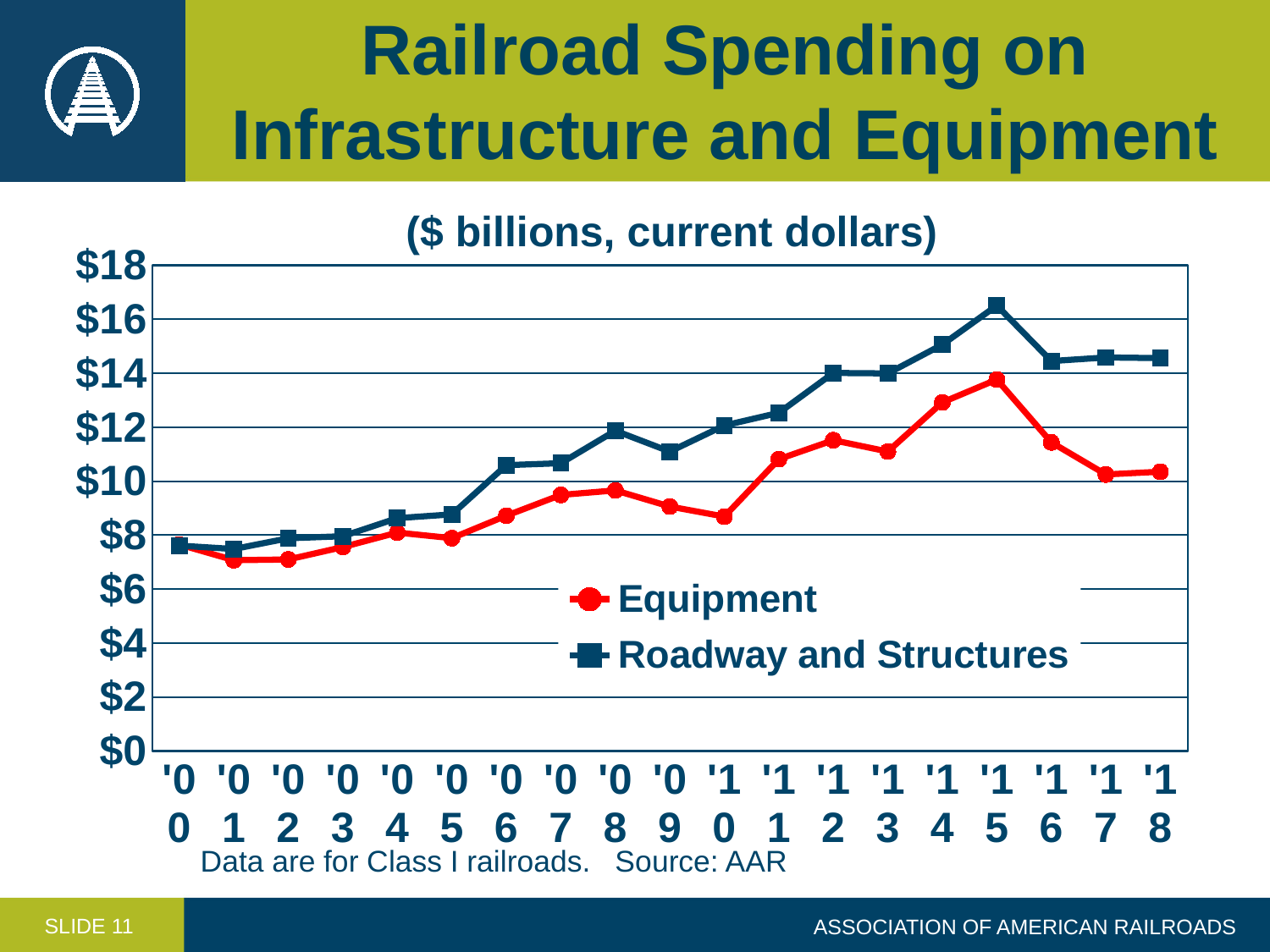
How many years are plotted along the x axis? 19 Which series is drawn in red with circle markers? Equipment Does the Roadway and Structures series generally rise or fall from '00 to '15? rise In which year does the Roadway and Structures series reach its highest value? '15 What kind of chart is shown on the slide? line chart In '15, which series has the larger value, Equipment or Roadway and Structures? Roadway and Structures How many series does the legend list? 2 Is the Roadway and Structures value for '15 greater or less than $16? greater Is the Equipment value for '10 greater or less than $10? less Is the Roadway and Structures value for '00 greater or less than $8? less In which year does the Equipment series reach its highest value? '15